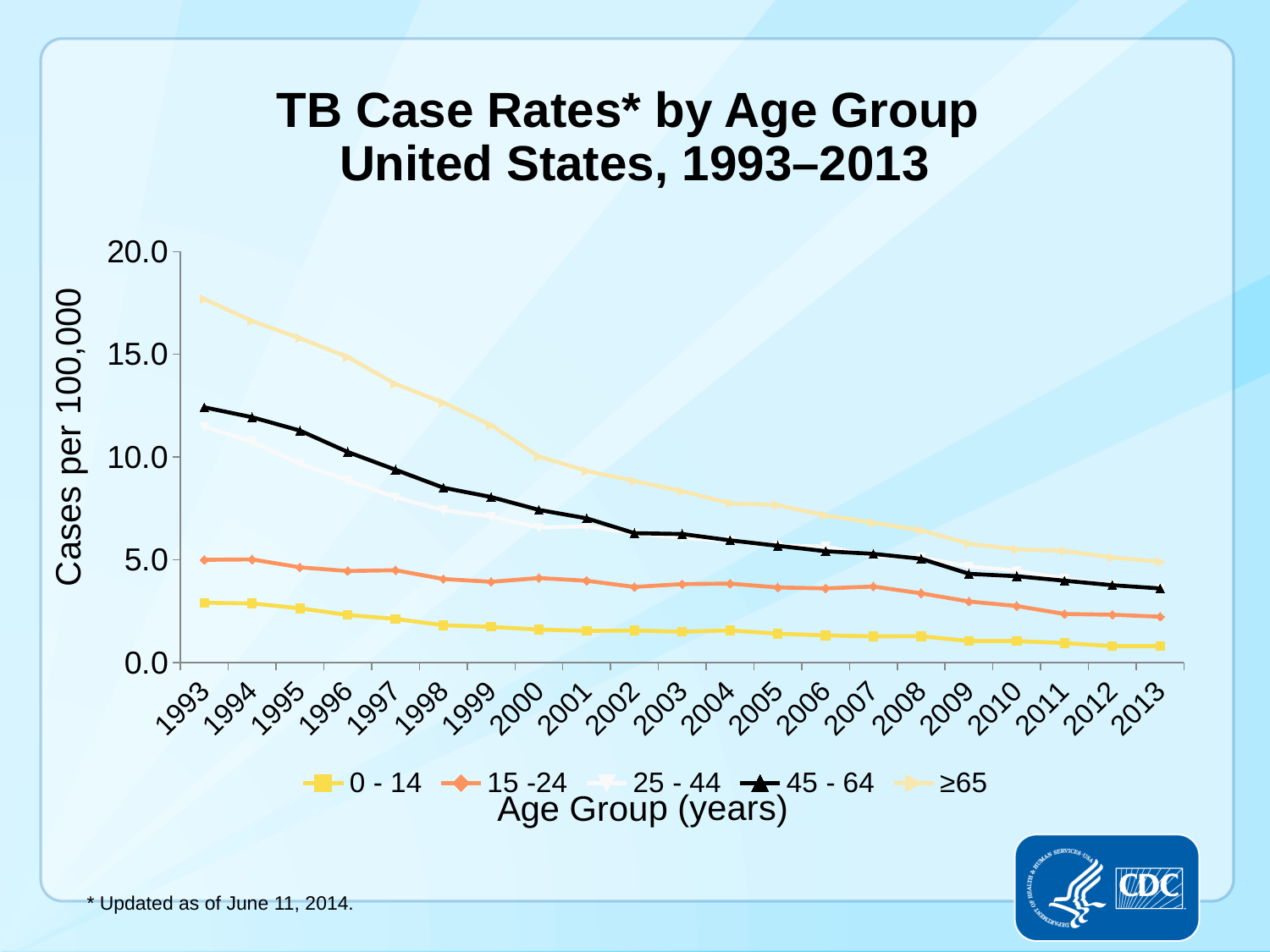
What is the title of the chart? TB Case Rates* by Age Group United States, 1993–2013 Which age group has the highest TB case rate in 1993? ≥65 In 1993, which is larger: the rate for the 45 - 64 age group or the 15 -24 age group? 45 - 64 Which age group has the lowest TB case rate in 2013? 0 - 14 Is the value for the 15 -24 age group in 1993 greater or less than 10.0? less What kind of chart is shown on the slide? line chart How many years are plotted along the x axis? 21 Does the TB case rate for the ≥65 age group rise or fall from 1993 to 2013? fall What is the label on the y axis of the chart? Cases per 100,000 How many age-group series does the legend list? 5 Is the value for the ≥65 age group in 1993 greater or less than 15.0? greater Is the value for the 45 - 64 age group in 2013 greater or less than 5.0? less